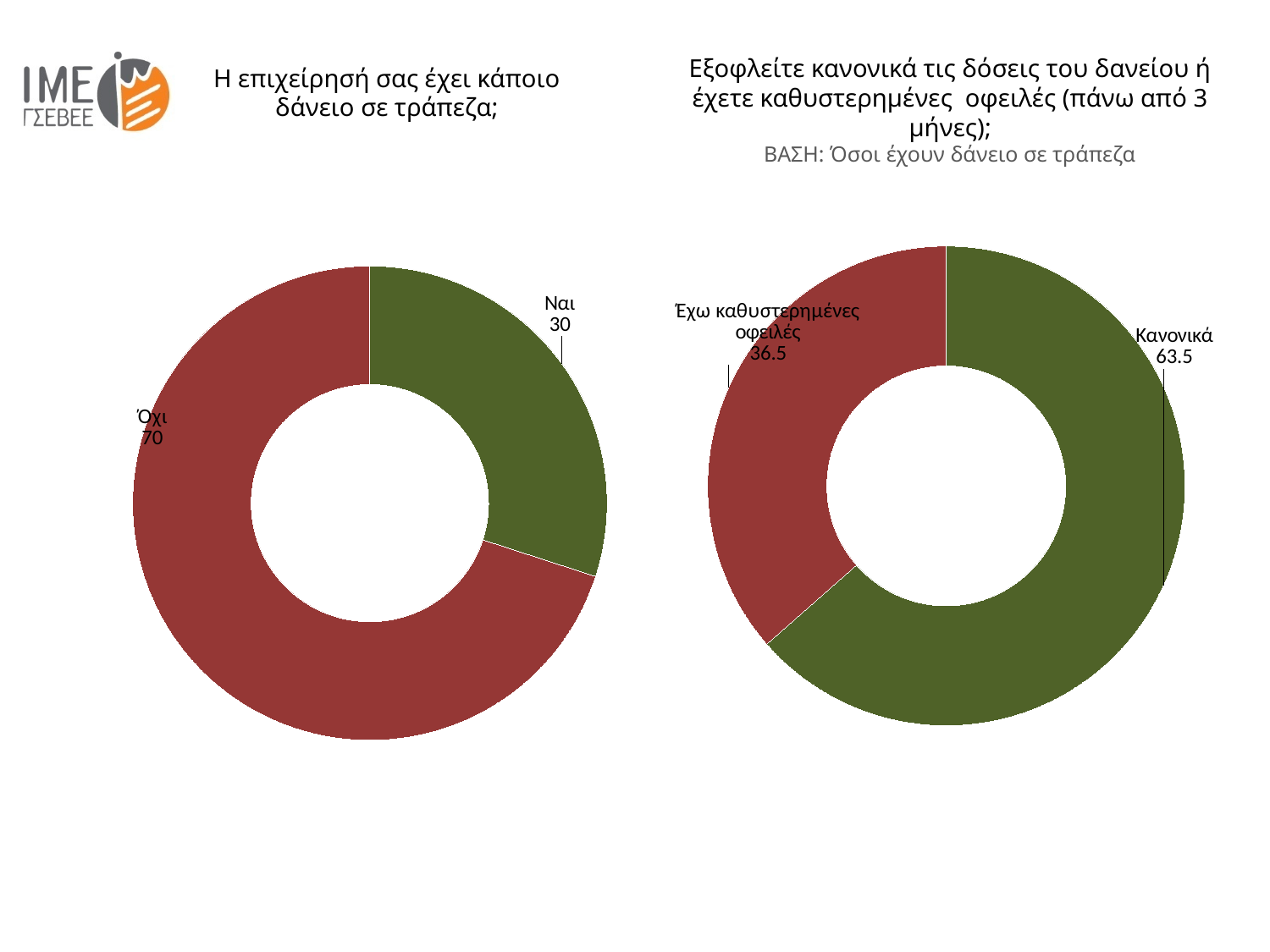
In the left chart, what is the difference between the values for Όχι and Ναι? 40 In the right chart (Εξοφλείτε κανονικά τις δόσεις του δανείου...), what is the value for Κανονικά? 63.5 How many categories does the left chart show? 2 What kind of chart is the right chart? Doughnut chart In the left chart (Η επιχείρησή σας έχει κάποιο δάνειο σε τράπεζα;), what is the value for Όχι? 70 In the right chart, which is larger: Κανονικά or Έχω καθυστερημένες οφειλές? Κανονικά In the right chart, which category has the smallest share? Έχω καθυστερημένες οφειλές In the left chart, which category has the largest share? Όχι In the right chart, what is the difference between the values for Κανονικά and Έχω καθυστερημένες οφειλές? 27 In the left chart (Η επιχείρησή σας έχει κάποιο δάνειο σε τράπεζα;), what is the value for Ναι? 30 In the right chart (Εξοφλείτε κανονικά τις δόσεις του δανείου...), what is the value for Έχω καθυστερημένες οφειλές? 36.5 What is the base (ΒΑΣΗ) stated under the title of the right chart? Όσοι έχουν δάνειο σε τράπεζα